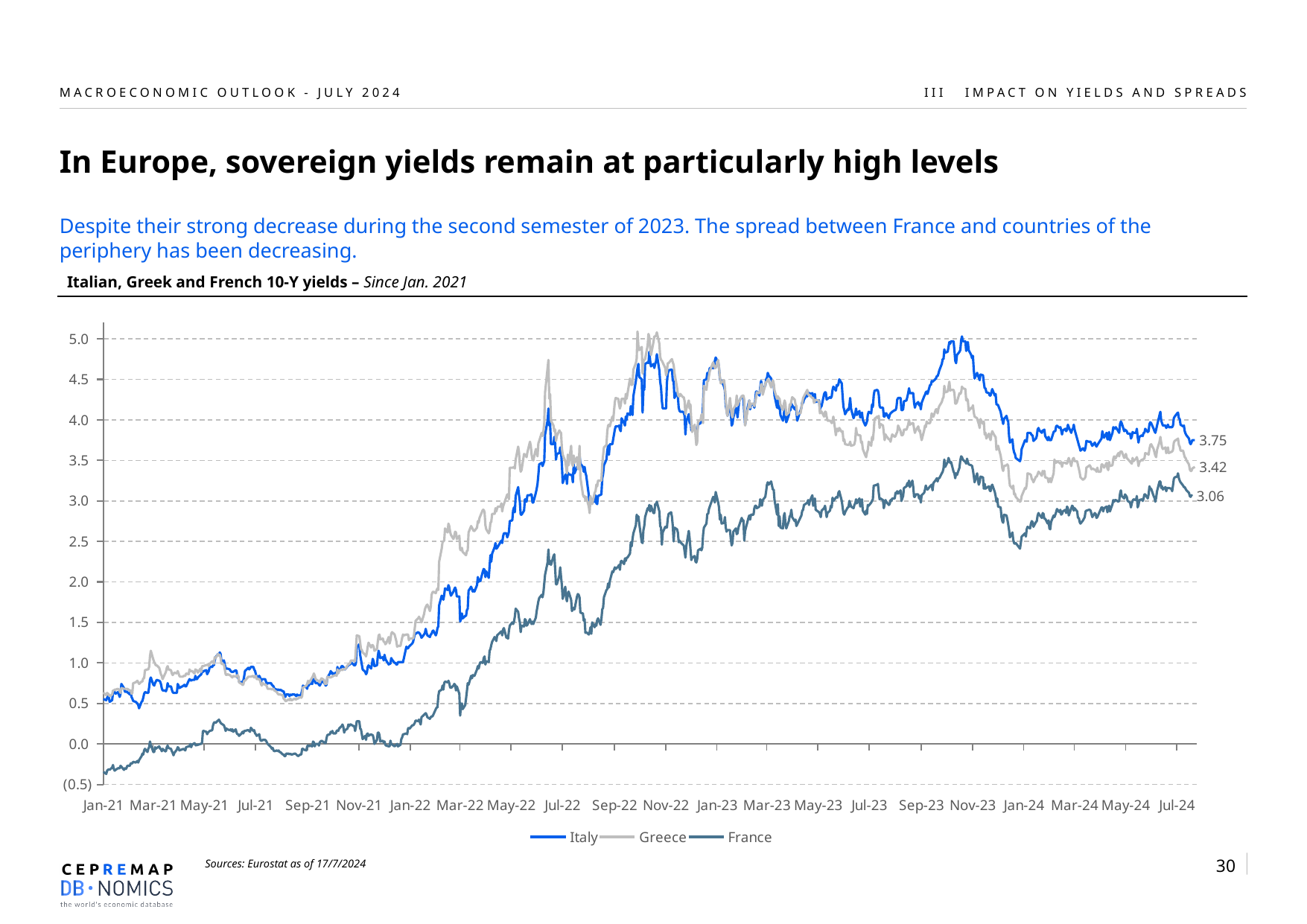
What kind of chart is shown on the slide? Line chart Is the peak value for Italy around Nov-23 greater or less than 4.5? greater What is the latest value shown for Italy's 10-year yield at the right end of the chart? 3.75 Overall, does the France series rise or fall from Jan-21 to Jul-24? Rise At the right end of the chart, which is higher: Italy or Greece? Italy Is the value for France in Jan-21 greater or less than 0.0? less What is the latest value shown for France's 10-year yield at the right end of the chart? 3.06 What is the difference between the latest labelled values for Italy and Greece? 0.33 What is the latest value shown for Greece's 10-year yield at the right end of the chart? 3.42 Which series has the lowest value at the right end of the chart? France How many series does the legend list? 3 What is the difference between the latest labelled values for Italy and France? 0.69